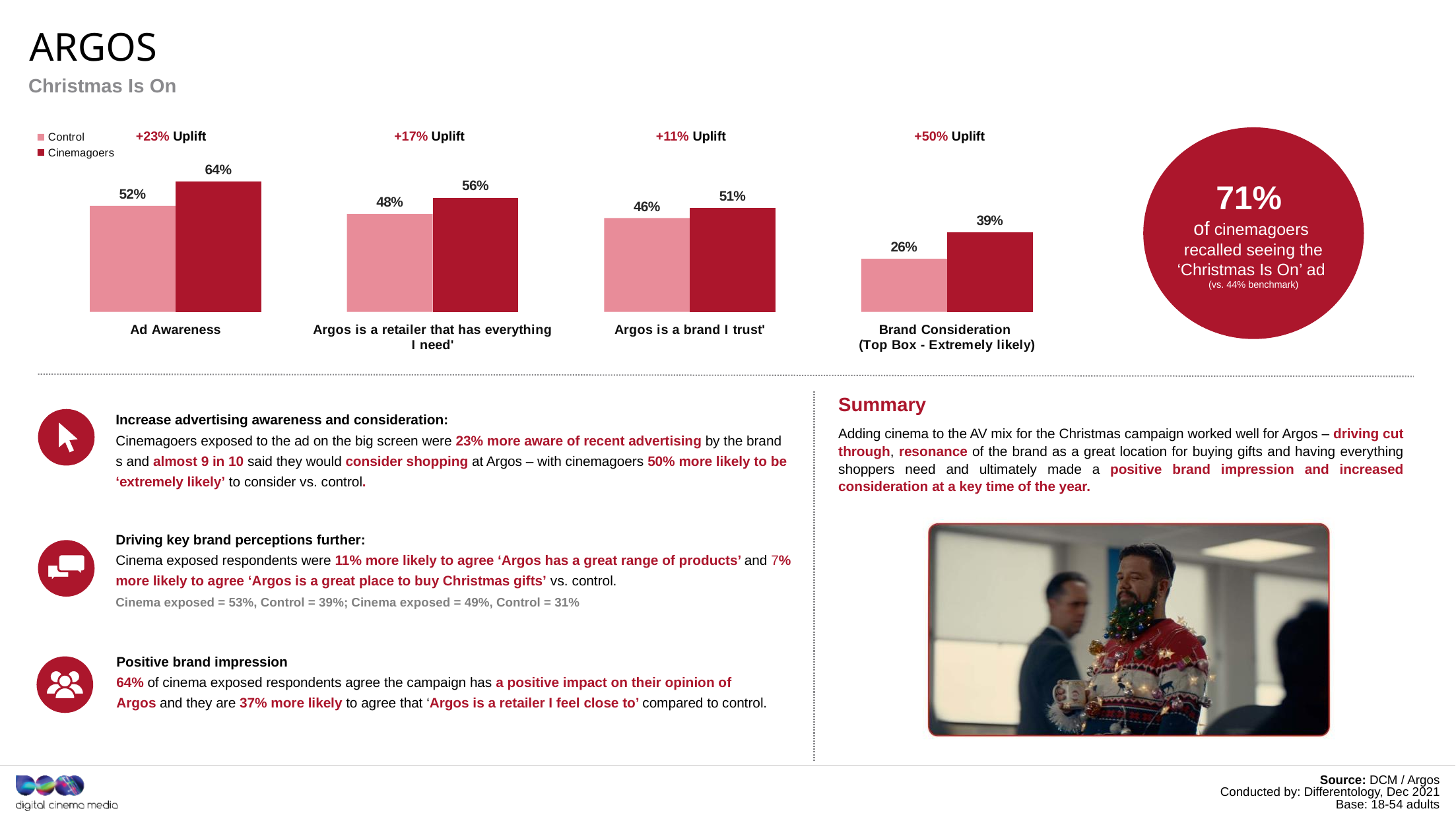
In the 'Argos is a brand I trust' chart, which is larger, Control or Cinemagoers? Cinemagoers What uplift is shown above the 'Argos is a retailer that has everything I need' chart? +17% Uplift What kind of chart is the Ad Awareness chart? Bar chart In the Brand Consideration (Top Box - Extremely likely) chart, what is the value for Cinemagoers? 39% What uplift is shown above the Brand Consideration (Top Box - Extremely likely) chart? +50% Uplift In the Ad Awareness chart, what is the value for Control? 52% How many series does the legend list for the bar charts? 2 In the Ad Awareness chart, what is the value for Cinemagoers? 64% In the Ad Awareness chart, what is the difference between the Cinemagoers and Control values? 12% In the 'Argos is a retailer that has everything I need' chart, what is the value for Cinemagoers? 56% In the Brand Consideration (Top Box - Extremely likely) chart, what is the difference between the Cinemagoers and Control values? 13% In the 'Argos is a brand I trust' chart, what is the value for Control? 46%